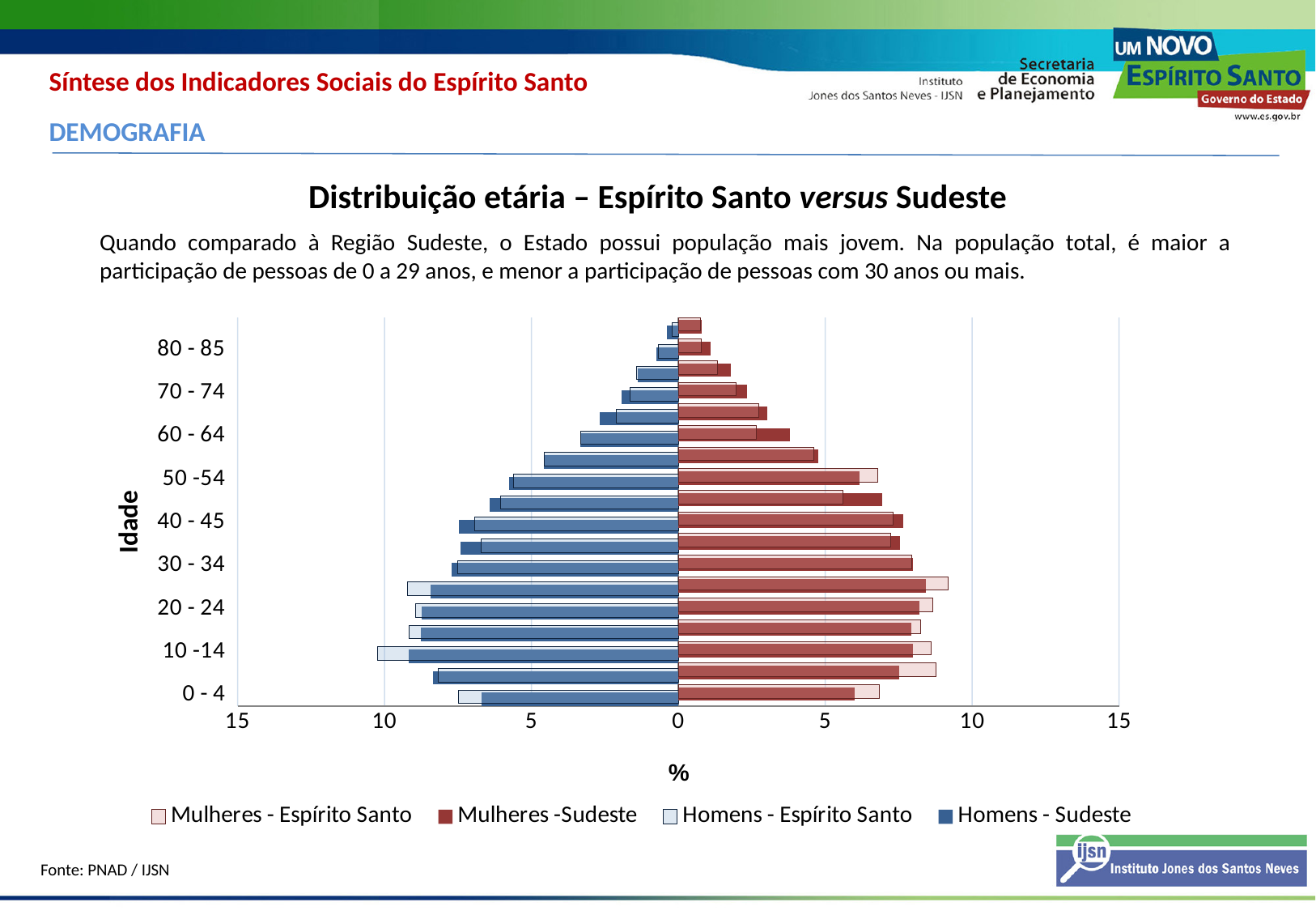
How many series does the chart legend list? 4 How many age-group labels are printed on the vertical axis? 9 What is the title of the chart on the slide? Distribuição etária – Espírito Santo versus Sudeste Is the value for Mulheres - Sudeste in the 0 - 4 age group greater or less than 5? greater For Homens - Sudeste, do the values rise or fall from the 30 - 34 age group up to the 80 - 85 age group? fall Which labelled age group has the longest Homens - Espírito Santo bar? 10 -14 What kind of chart is shown on the slide? bar chart Is the value for Homens - Sudeste in the 80 - 85 age group greater or less than 5? less In the 0 - 4 age group, which is larger: Homens - Espírito Santo or Homens - Sudeste? Homens - Espírito Santo What label is shown on the vertical axis of the chart? Idade Is the value for Homens - Espírito Santo in the 10 -14 age group greater or less than 10? greater